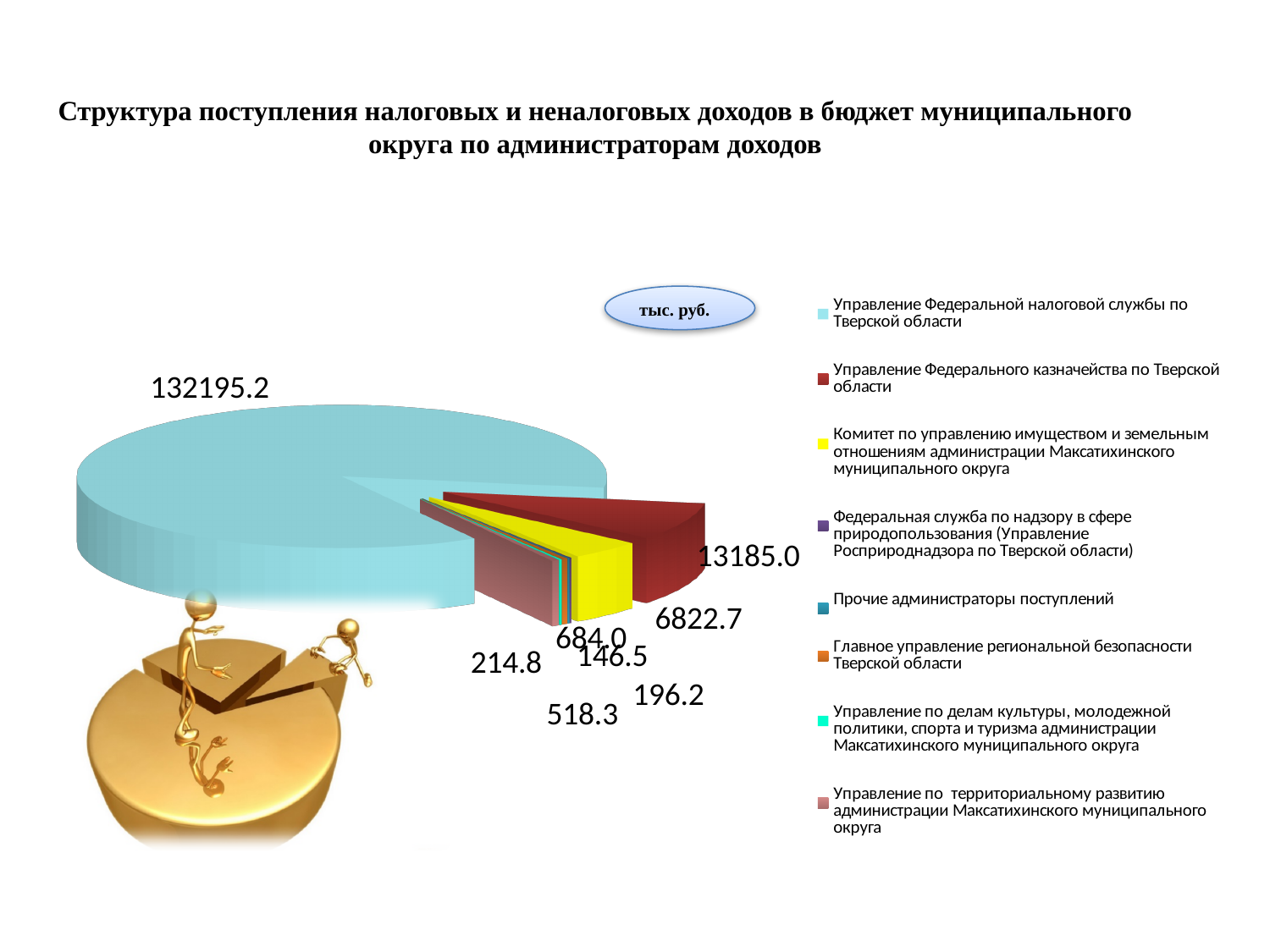
In what units are the values on the chart given? тыс. руб. What colour is the slice for Управление Федерального казначейства по Тверской области? Red What is the value for Управление Федерального казначейства по Тверской области? 13185.0 What kind of chart is shown on the slide? Pie chart Which administrator has the largest share of the pie? Управление Федеральной налоговой службы по Тверской области What is the smallest value labelled on the pie chart? 146.5 What is the difference between the values for Управление Федеральной налоговой службы and Управление Федерального казначейства? 119010.2 How many administrators (categories) does the legend list? 8 What is the value for Комитет по управлению имуществом и земельным отношениям администрации Максатихинского муниципального округа? 6822.7 Which is larger: the value for Управление Федерального казначейства по Тверской области or for Комитет по управлению имуществом и земельным отношениям? Управление Федерального казначейства по Тверской области What is the value for Управление Федеральной налоговой службы по Тверской области? 132195.2 What is the difference between the values for Управление Федерального казначейства по Тверской области and Комитет по управлению имуществом и земельным отношениям? 6362.3